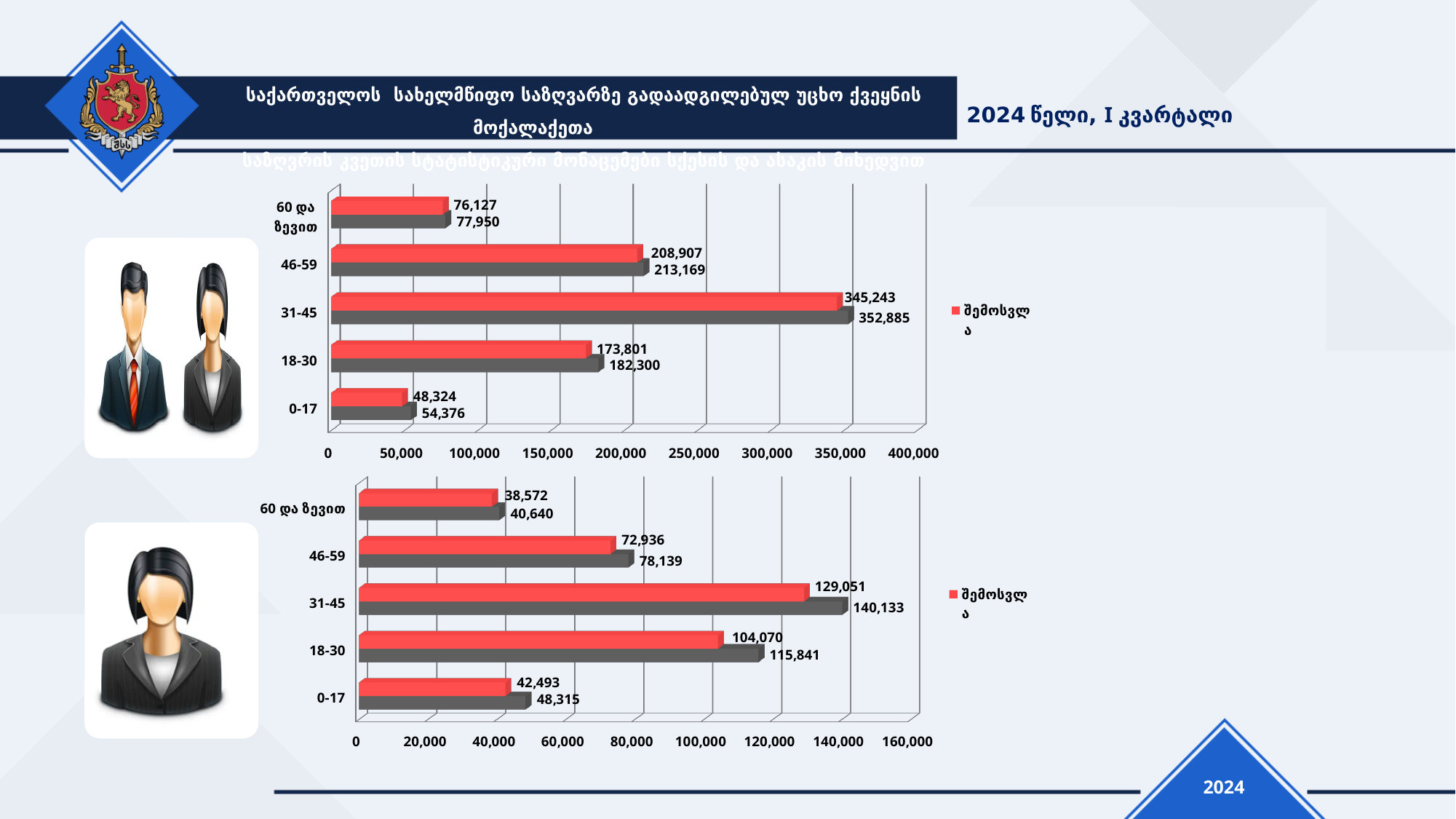
What type of chart is the top chart? bar chart In the top chart, what is the value of the red bar for the 0-17 age group? 48,324 In the top chart, what is the difference between the grey bar and the red bar for the 46-59 age group? 4,262 In the top chart, which age group has the highest red bar? 31-45 In the top chart, is the grey bar for the 18-30 age group greater or less than 150,000? greater In the bottom chart, which red bar is larger: 0-17 or 60 და ზევით? 0-17 In the bottom chart, what is the difference between the grey bar and the red bar for the 31-45 age group? 11,082 In the bottom chart, which age group has the lowest grey bar? 60 და ზევით What label does the legend of the top chart show for the red series? შემოსვლა In the bottom chart, what is the value of the grey bar for the 18-30 age group? 115,841 How many age groups are shown in the bottom chart? 5 In the top chart, what is the value of the red bar for the 31-45 age group? 345,243